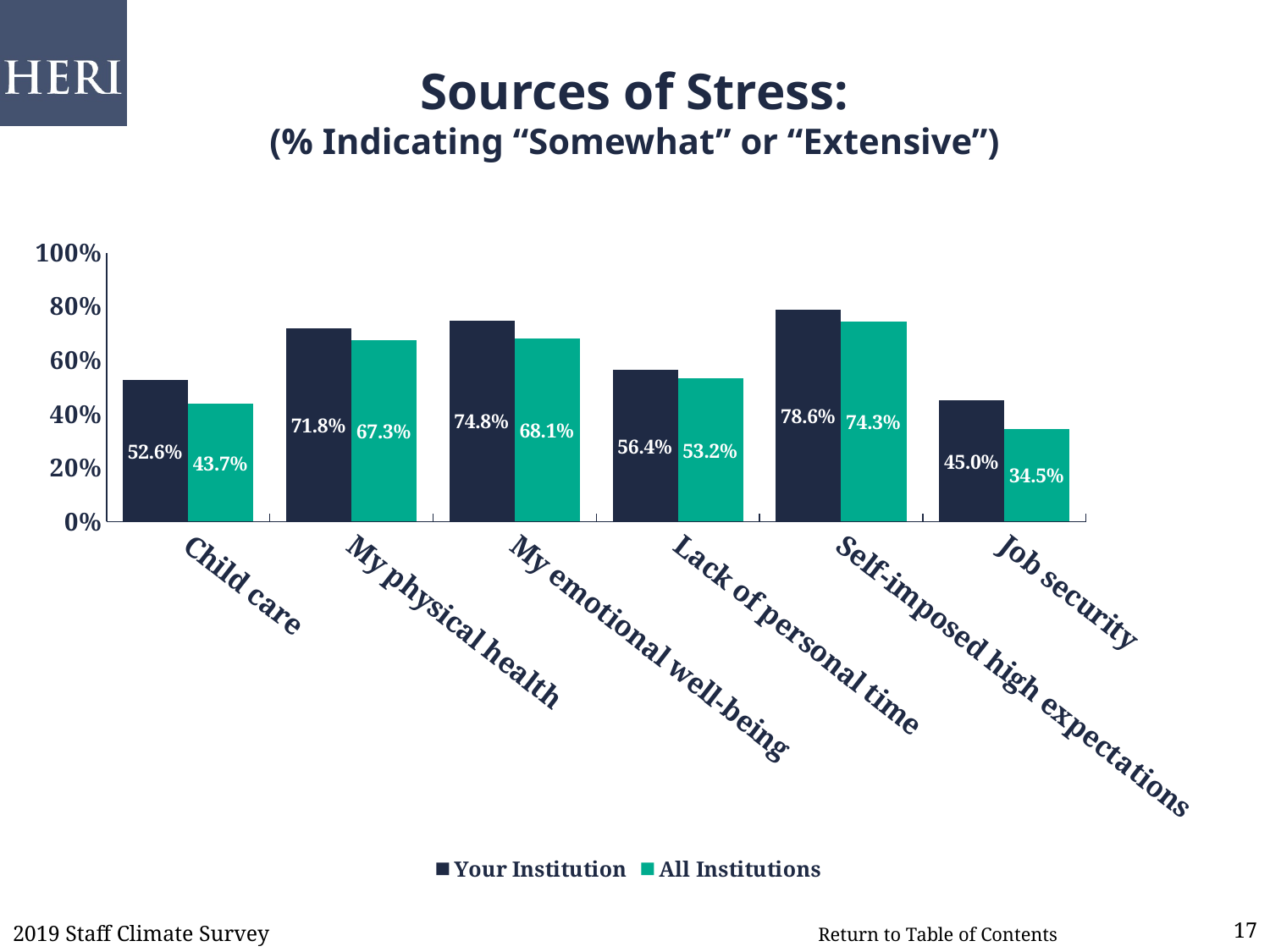
Is the value for All Institutions for My physical health greater or less than 60%? greater What is the difference between Your Institution and All Institutions for Job security? 10.5% What is the value for Your Institution for Child care? 52.6% How many categories are shown on the x axis? 6 What is the difference between Your Institution and All Institutions for Child care? 8.9% What is the value for All Institutions for My emotional well-being? 68.1% Which is larger for Lack of personal time: Your Institution or All Institutions? Your Institution What kind of chart is shown on the slide? bar chart Which category has the lowest value for All Institutions? Job security Which category has the highest value for Your Institution? Self-imposed high expectations What is the value for All Institutions for Job security? 34.5% How many series does the legend list? 2